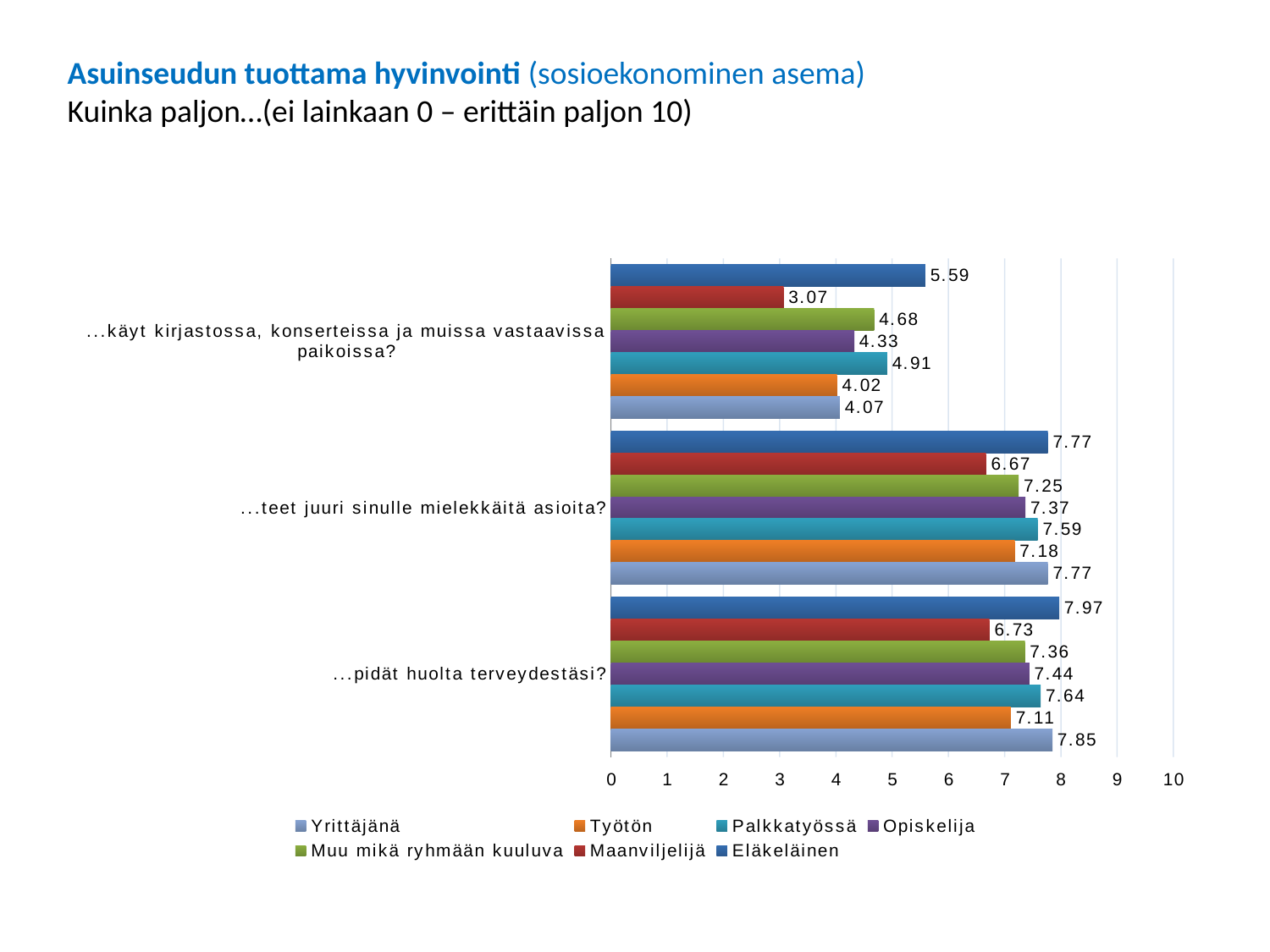
How many categories are shown on the chart? 3 How many series does the legend list? 7 Which series has the highest value in the category "...pidät huolta terveydestäsi?"? Eläkeläinen Is the value for Maanviljelijä in the category "...teet juuri sinulle mielekkäitä asioita?" greater or less than 7? less What is the value for Maanviljelijä in the category "...pidät huolta terveydestäsi?"? 6.73 What is the value for Yrittäjänä in the category "...pidät huolta terveydestäsi?"? 7.85 What is the difference between the Eläkeläinen and Maanviljelijä values in the category "...käyt kirjastossa, konserteissa ja muissa vastaavissa paikoissa?"? 2.52 What is the value for Eläkeläinen in the category "...käyt kirjastossa, konserteissa ja muissa vastaavissa paikoissa?"? 5.59 What kind of chart is shown on the slide? bar chart What is the value for Työtön in the category "...teet juuri sinulle mielekkäitä asioita?"? 7.18 In the category "...pidät huolta terveydestäsi?", which is larger: the value for Palkkatyössä or the value for Opiskelija? Palkkatyössä Which series has the lowest value in the category "...käyt kirjastossa, konserteissa ja muissa vastaavissa paikoissa?"? Maanviljelijä